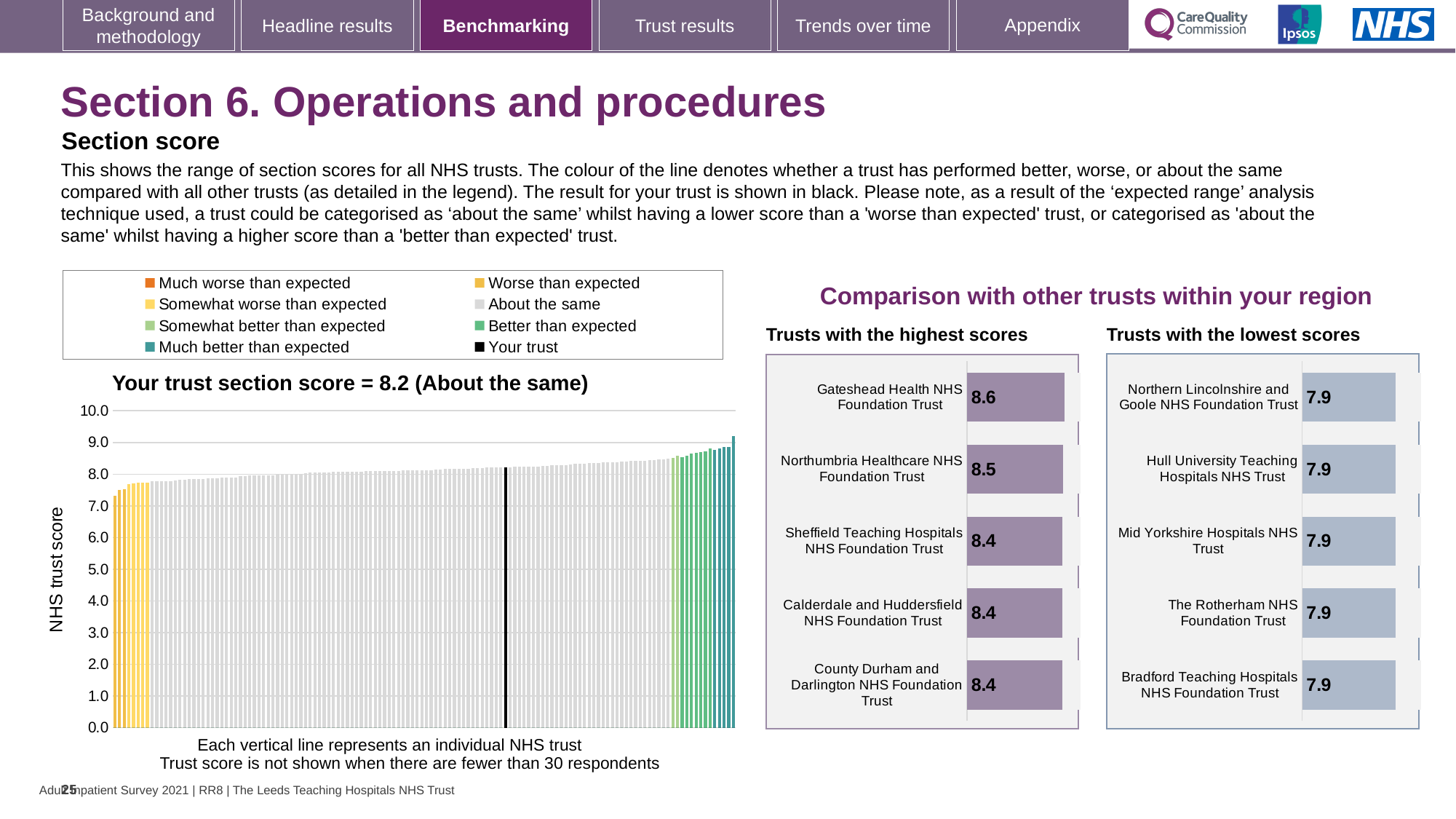
In the 'Trusts with the highest scores' chart, what is the score for Gateshead Health NHS Foundation Trust? 8.6 In the 'Your trust section score' chart, what is the section score for your trust? 8.2 What kind of chart is the 'Your trust section score' chart? bar chart In the 'Your trust section score' chart, is the value of the leftmost bar greater or less than 8.0? less In the 'Your trust section score' chart, do the bars rise or fall from left to right? rise In the 'Trusts with the highest scores' chart, which has the larger score: Gateshead Health NHS Foundation Trust or Northumbria Healthcare NHS Foundation Trust? Gateshead Health NHS Foundation Trust In the 'Trusts with the lowest scores' chart, what is the score for Mid Yorkshire Hospitals NHS Trust? 7.9 In the 'Your trust section score' chart, what is the label on the vertical axis? NHS trust score In the 'Trusts with the highest scores' chart, how many trusts are shown? 5 In the 'Trusts with the highest scores' chart, which trust has the highest score? Gateshead Health NHS Foundation Trust In the 'Trusts with the highest scores' chart, what is the difference between the scores of Gateshead Health NHS Foundation Trust and Sheffield Teaching Hospitals NHS Foundation Trust? 0.2 How many entries does the legend above the 'Your trust section score' chart list? 8